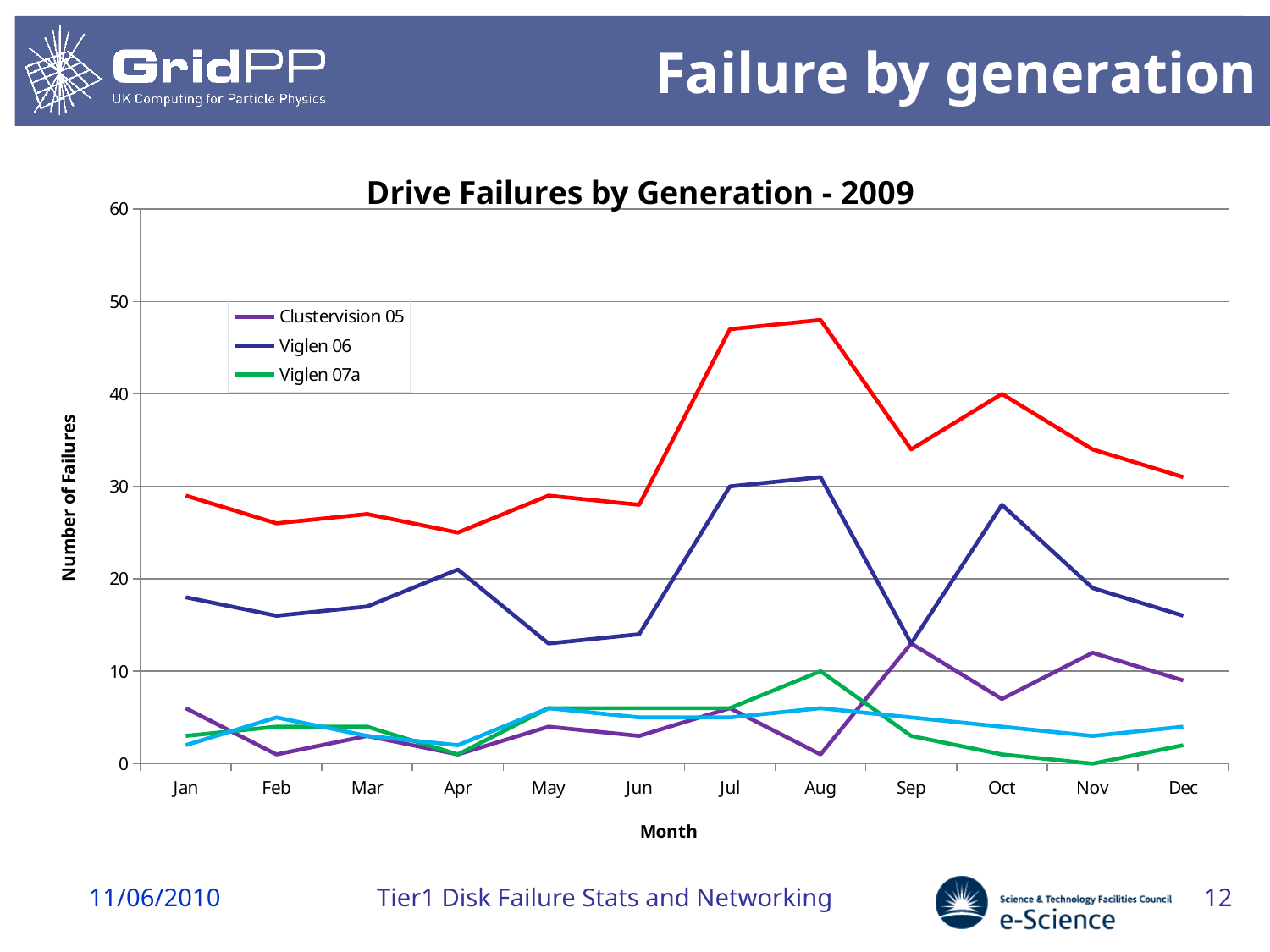
What kind of chart is shown on the slide? line chart In which month is the Viglen 07a series lowest? Nov In Jan, which series has the larger value, Viglen 06 or Clustervision 05? Viglen 06 Is the value for Viglen 06 in Oct greater or less than 20? greater What is the value for Viglen 07a in Nov? 0 In which month is the Viglen 07a series highest? Aug How many series does the chart legend list? 3 How many months are shown along the x axis? 12 What is the label of the y axis? Number of Failures Is the value for Viglen 06 in May greater or less than 20? less Is the value for Clustervision 05 in Aug greater or less than 10? less What is the title of the chart? Drive Failures by Generation - 2009